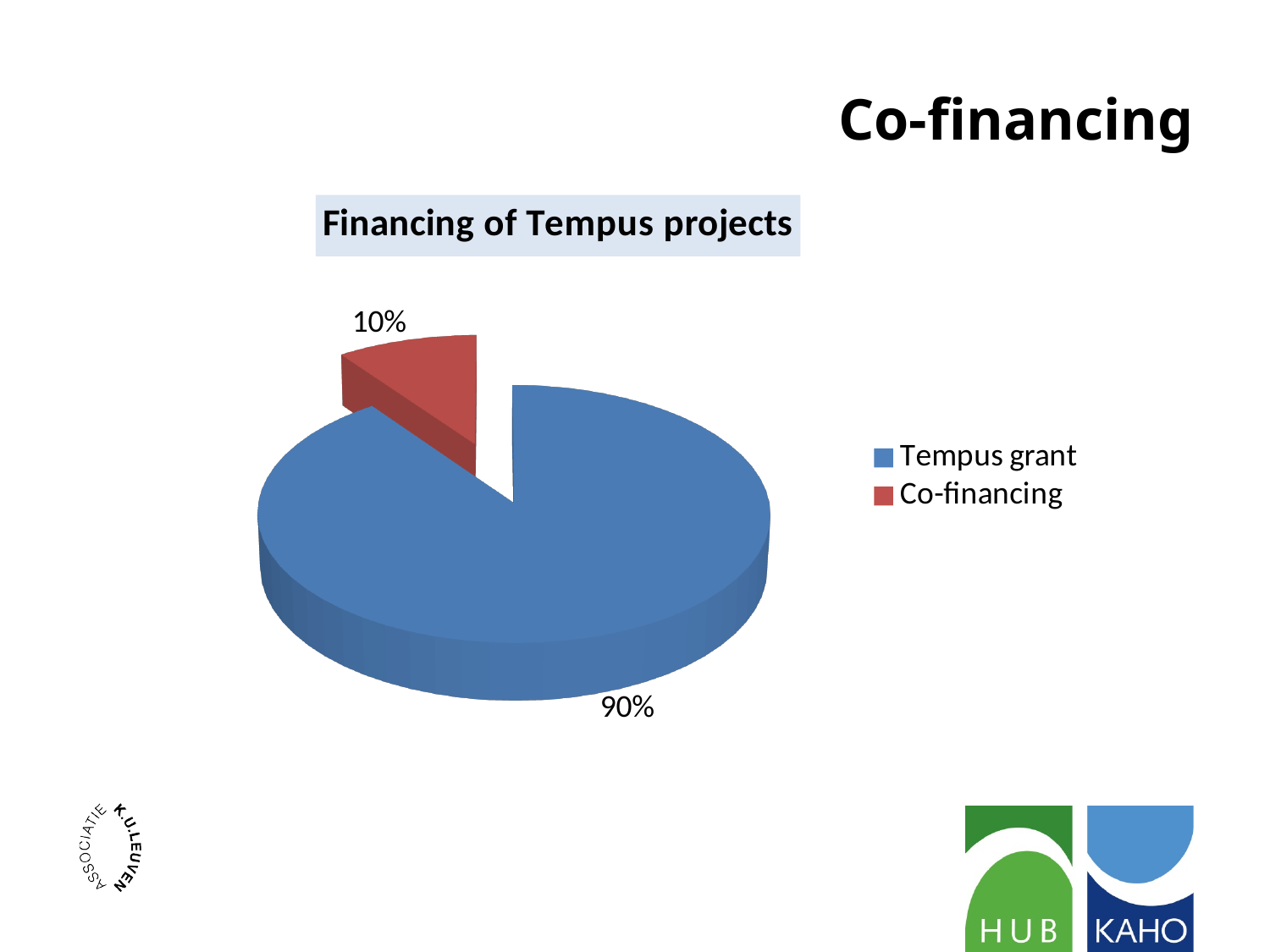
What colour is the Co-financing slice? Red How many entries does the legend list? 2 What is the difference in percentage points between the Tempus grant share and the Co-financing share? 80 percentage points Which slice of the pie is the largest? Tempus grant What share of the pie does Tempus grant represent? 90% What is the title of the chart? Financing of Tempus projects How many slices does the pie chart have? 2 What kind of chart is shown on the slide? Pie chart Which is larger, the Tempus grant share or the Co-financing share? Tempus grant Which slice of the pie is the smallest? Co-financing What share of the pie does Co-financing represent? 10%